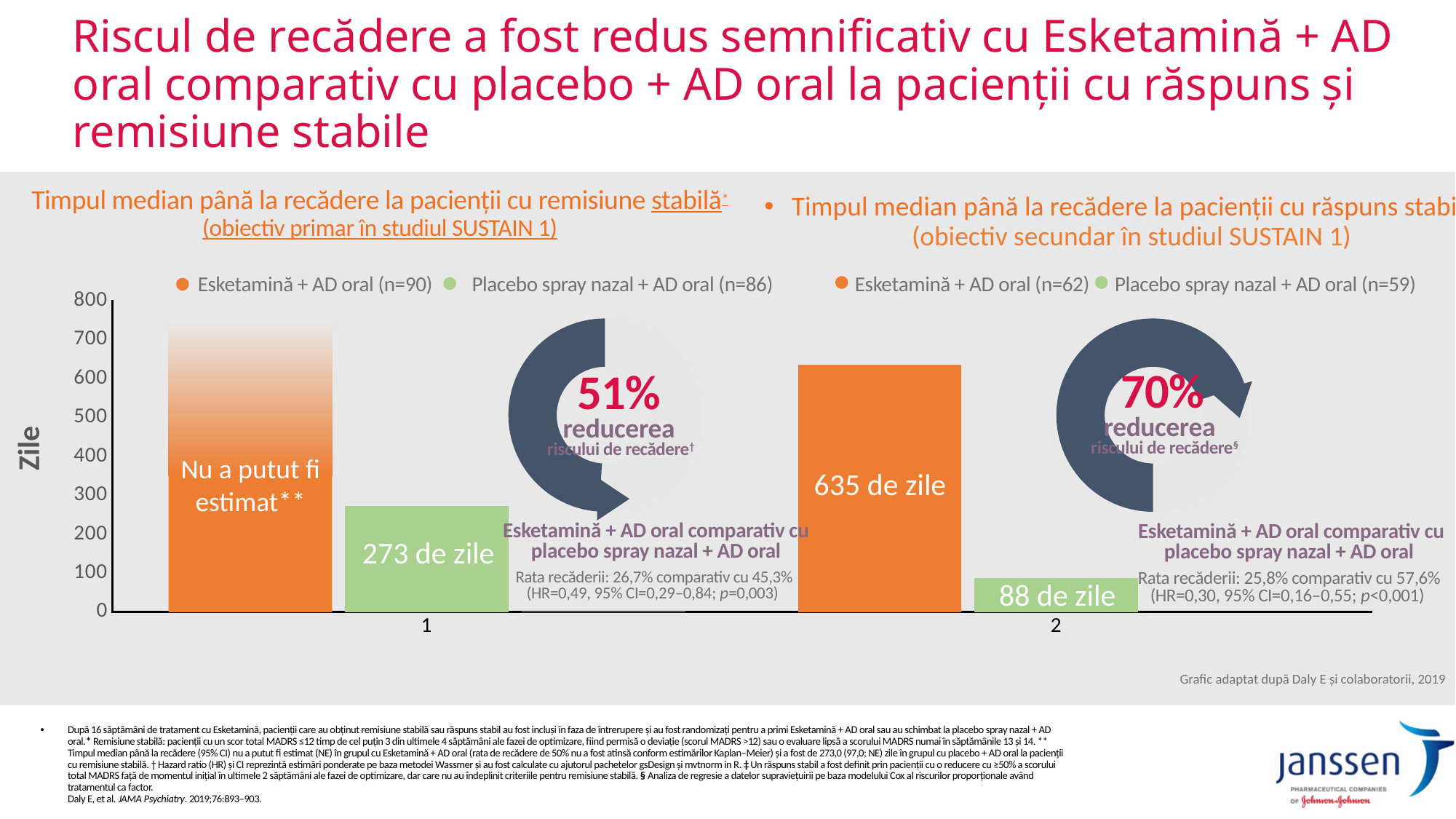
What is the difference in median time to relapse between Esketamină + AD oral and Placebo spray nazal + AD oral in group 2? 547 de zile Is the value for Placebo spray nazal + AD oral in group 1 greater or less than 300? less What is the median time to relapse for Placebo spray nazal + AD oral in the stable response group (group 2)? 88 de zile What label is shown on the Esketamină + AD oral bar in the stable remission group (group 1)? Nu a putut fi estimat** What is the maximum value shown on the vertical axis? 800 What is the median time to relapse for Placebo spray nazal + AD oral in the stable remission group (group 1)? 273 de zile What is the label of the vertical axis? Zile In group 2, which treatment has the longer median time to relapse? Esketamină + AD oral What is the median time to relapse for Esketamină + AD oral in the stable response group (group 2)? 635 de zile Which bar with a printed value is the lowest on the chart? Placebo spray nazal + AD oral in group 2 (88 de zile) Is the value for Esketamină + AD oral in group 2 greater or less than 600? greater What kind of chart is shown on the slide? bar chart